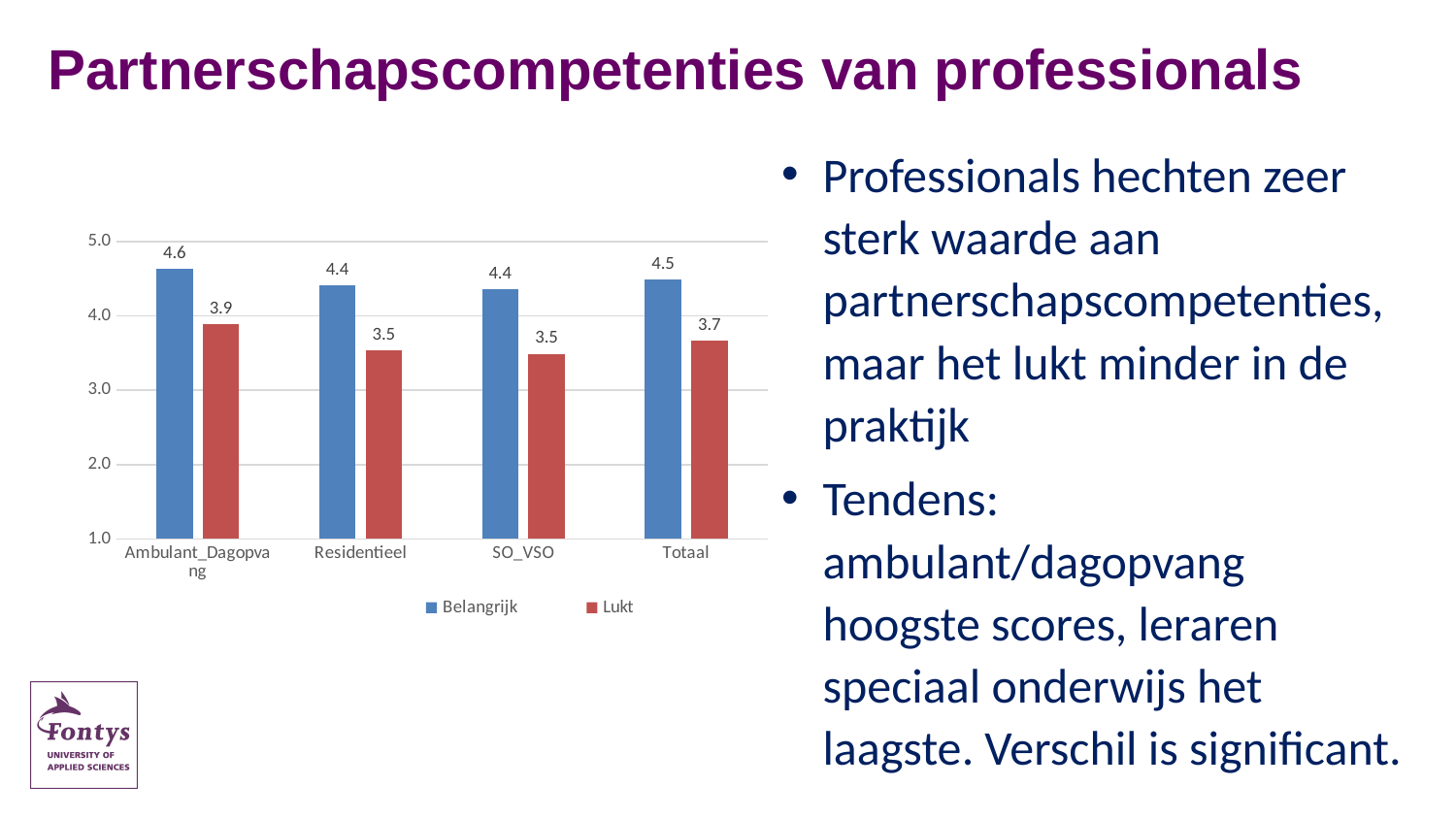
What is the Lukt value for Residentieel? 3.5 What is the Lukt value for Totaal? 3.7 What is the difference between the Belangrijk and Lukt values for Totaal? 0.8 What is the Belangrijk value for SO_VSO? 4.4 Which category has the highest Lukt value? Ambulant_Dagopvang What is the difference between the Belangrijk and Lukt values for Ambulant_Dagopvang? 0.7 What kind of chart is shown on the slide? Bar chart Which category has the highest Belangrijk value? Ambulant_Dagopvang How many categories are shown on the x axis? 4 What is the Belangrijk value for Ambulant_Dagopvang? 4.6 Which is larger for Residentieel: the Belangrijk value or the Lukt value? Belangrijk How many series does the legend list? 2